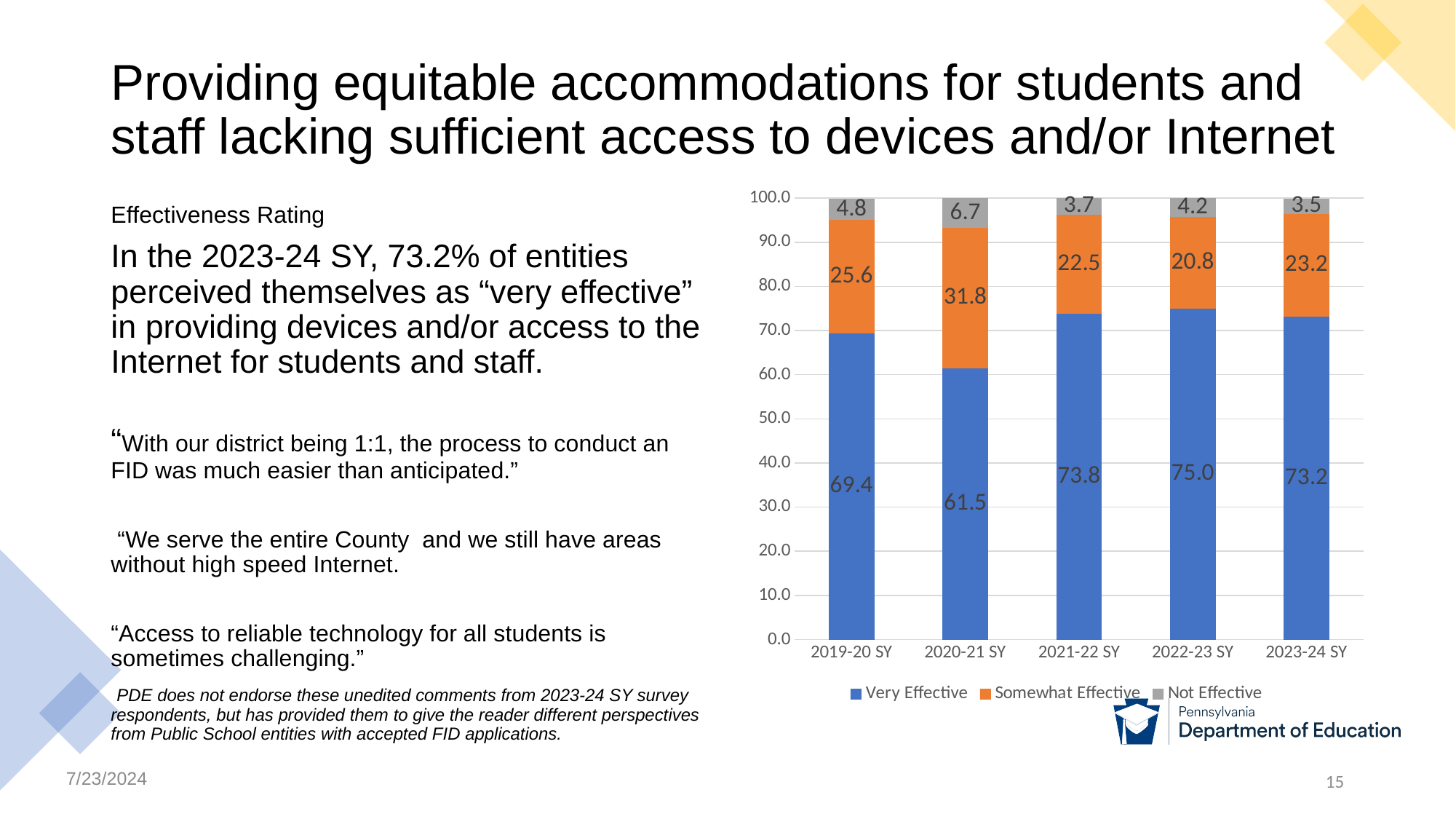
Which school year has the highest Not Effective value? 2020-21 SY Which school year has the lowest Very Effective value? 2020-21 SY Which school year has the highest Very Effective value? 2022-23 SY What kind of chart is shown on the slide? Stacked bar chart How many series does the legend list? 3 What is the Very Effective value for 2023-24 SY? 73.2 Which is larger, the Somewhat Effective value for 2019-20 SY or for 2023-24 SY? 2019-20 SY How many school years are shown on the x axis? 5 What is the Not Effective value for 2021-22 SY? 3.7 What is the difference between the Very Effective values for 2022-23 SY and 2020-21 SY? 13.5 What is the Somewhat Effective value for 2020-21 SY? 31.8 What is the total of the stacked bar for 2020-21 SY? 100.0